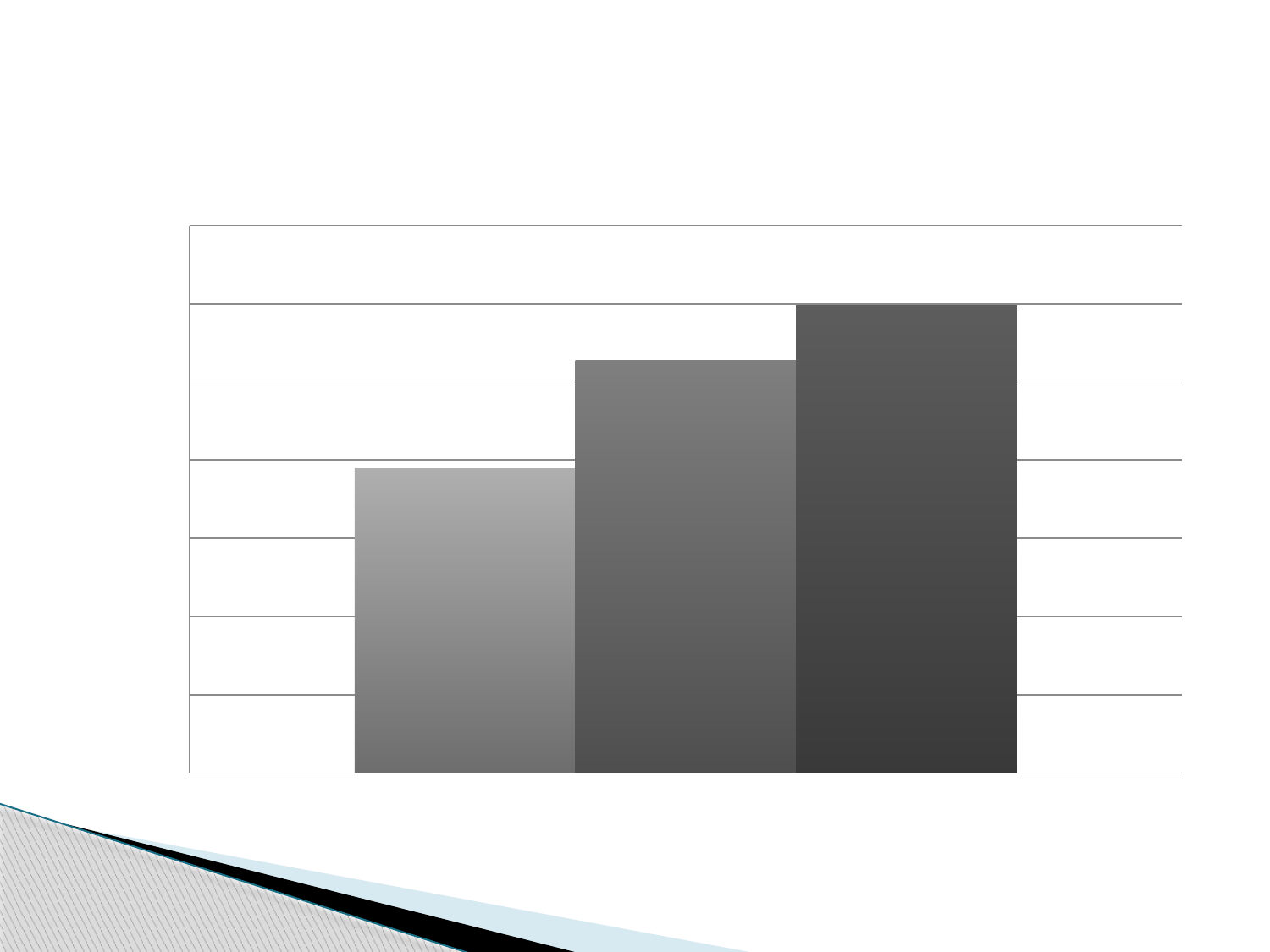
Which bar is the tallest: the leftmost, middle, or rightmost? rightmost Is the leftmost bar taller or shorter than the middle bar? shorter What kind of chart is shown on the slide? bar chart Does the chart display a title? no Do the bar heights rise or fall from left to right across the chart? rise Is the rightmost bar taller or shorter than the middle bar? taller Which bar is the lightest in colour: the leftmost, middle, or rightmost? leftmost Which bar is the shortest: the leftmost, middle, or rightmost? leftmost How many bars are plotted in the chart? 3